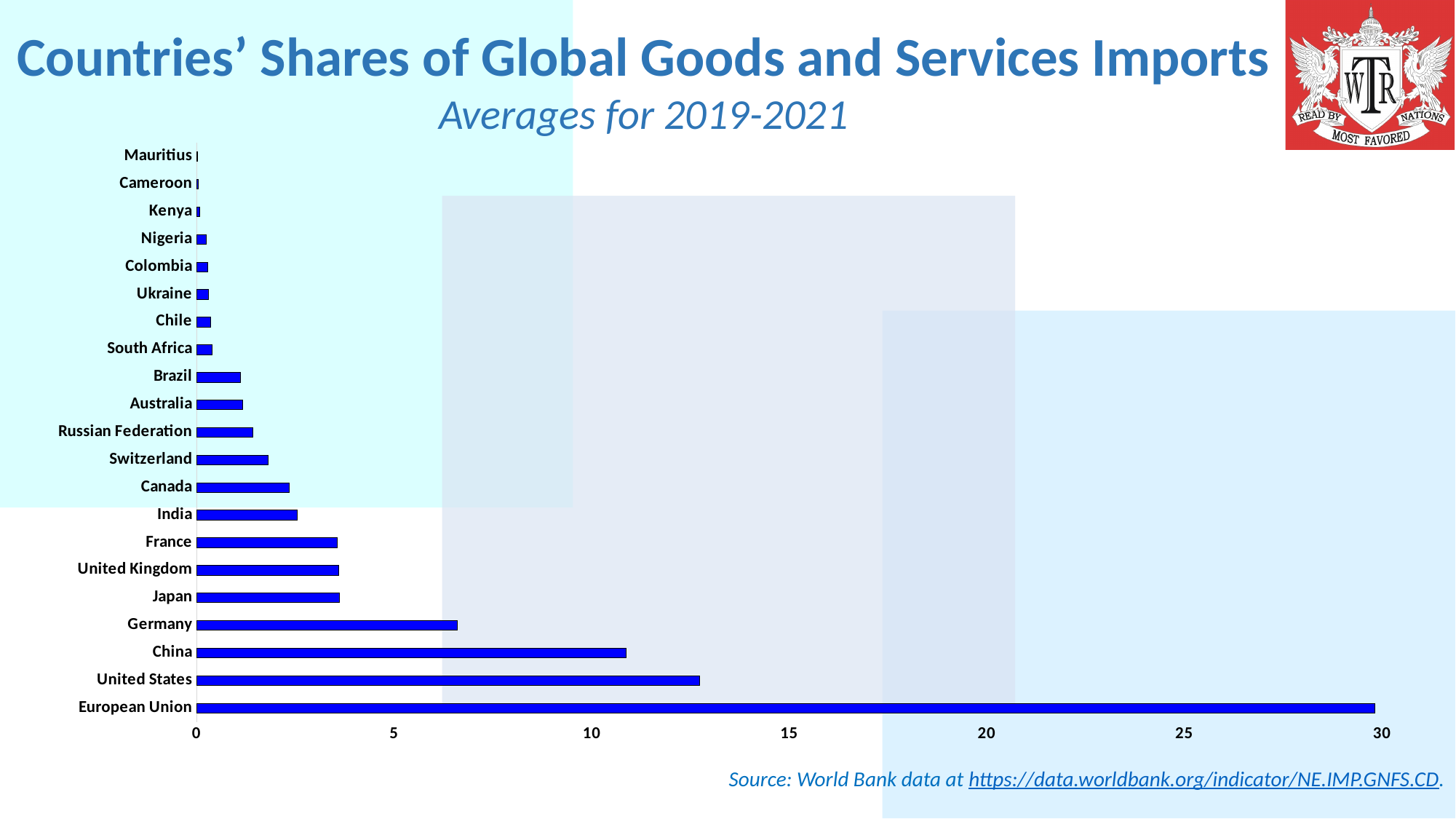
Is the value for the European Union greater or less than 25? greater What period do the averages in the chart cover, according to the subtitle? 2019-2021 Is the value for Japan greater or less than 5? less Which has the larger share, Germany or Japan? Germany Is the value for Germany greater or less than 10? less Which has the larger share, Switzerland or Brazil? Switzerland Which has the larger share, the United States or China? United States Which country or region has the highest share of global goods and services imports? European Union How many countries or regions are plotted in the chart? 21 What kind of chart is shown on the slide? bar chart